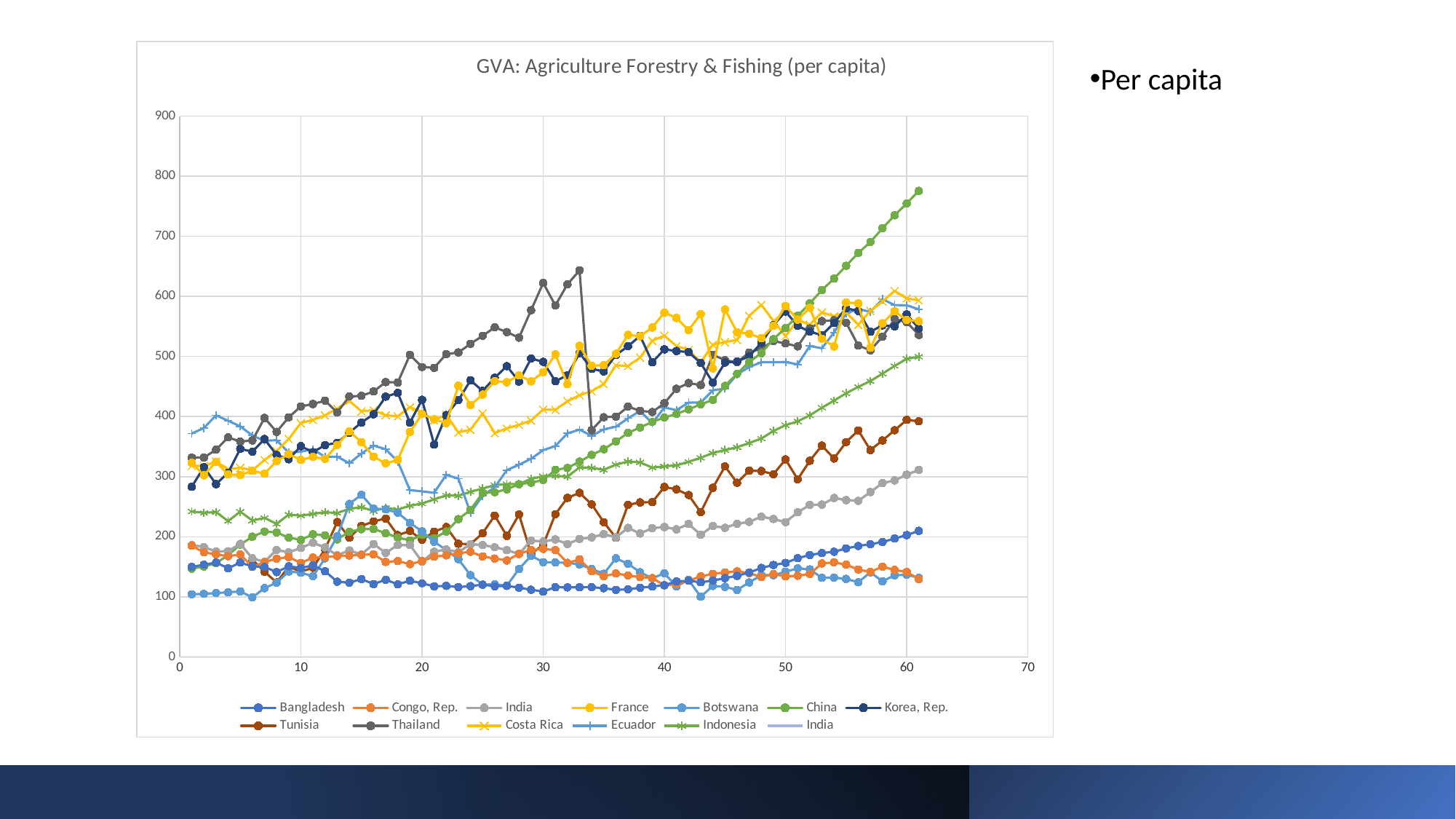
How many series does the legend list? 13 At x = 61, which is larger, the value for Tunisia or the value for India (grey line)? Tunisia At x = 61, which is larger, the value for China or the value for France? China What is the title of the chart? GVA: Agriculture Forestry & Fishing (per capita) Does the China series generally rise or fall along the x axis? rise Is the peak value for Thailand (around x = 33) greater or less than 600? greater Is the value for Tunisia at x = 61 greater or less than 500? less Is the value for China at x = 61 greater or less than 700? greater Which series has the highest value at the right end of the chart (x = 61)? China What is the highest value shown on the vertical axis? 900 What kind of chart is shown on the slide? line chart